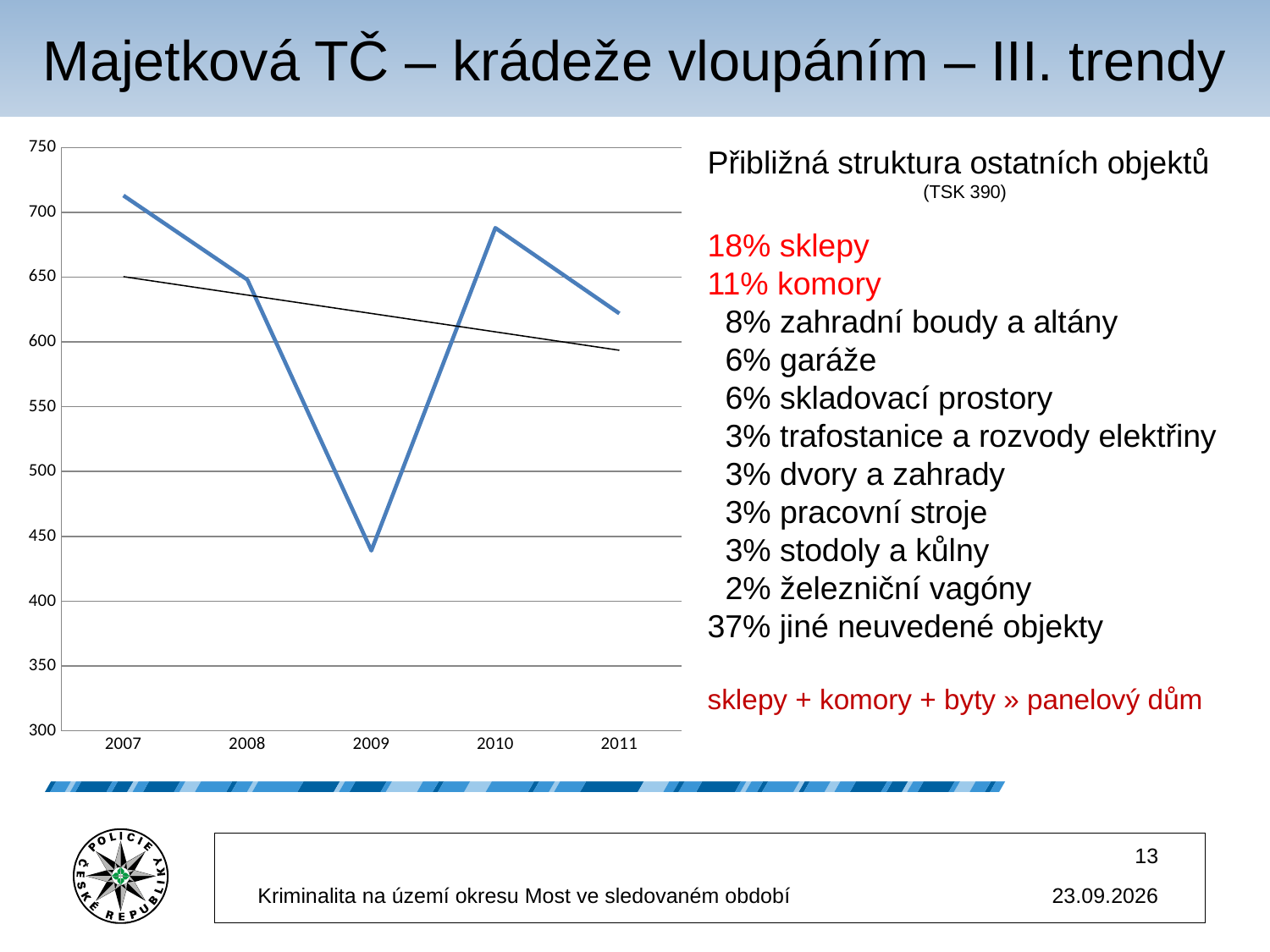
Is the value for 2010 greater or less than 650? greater Which year has the highest value in the chart? 2007 Which year has the larger value, 2009 or 2010? 2010 What is the lowest value shown on the y axis of the chart? 300 Is the value for 2009 greater or less than 500? less Which year has the lowest value in the chart? 2009 Does the straight black trend line rise or fall from 2007 to 2011? fall What kind of chart is shown on the slide? line chart Is the value for 2007 greater or less than 700? greater How many years are plotted along the x axis of the chart? 5 Does the value rise or fall from 2008 to 2009? fall